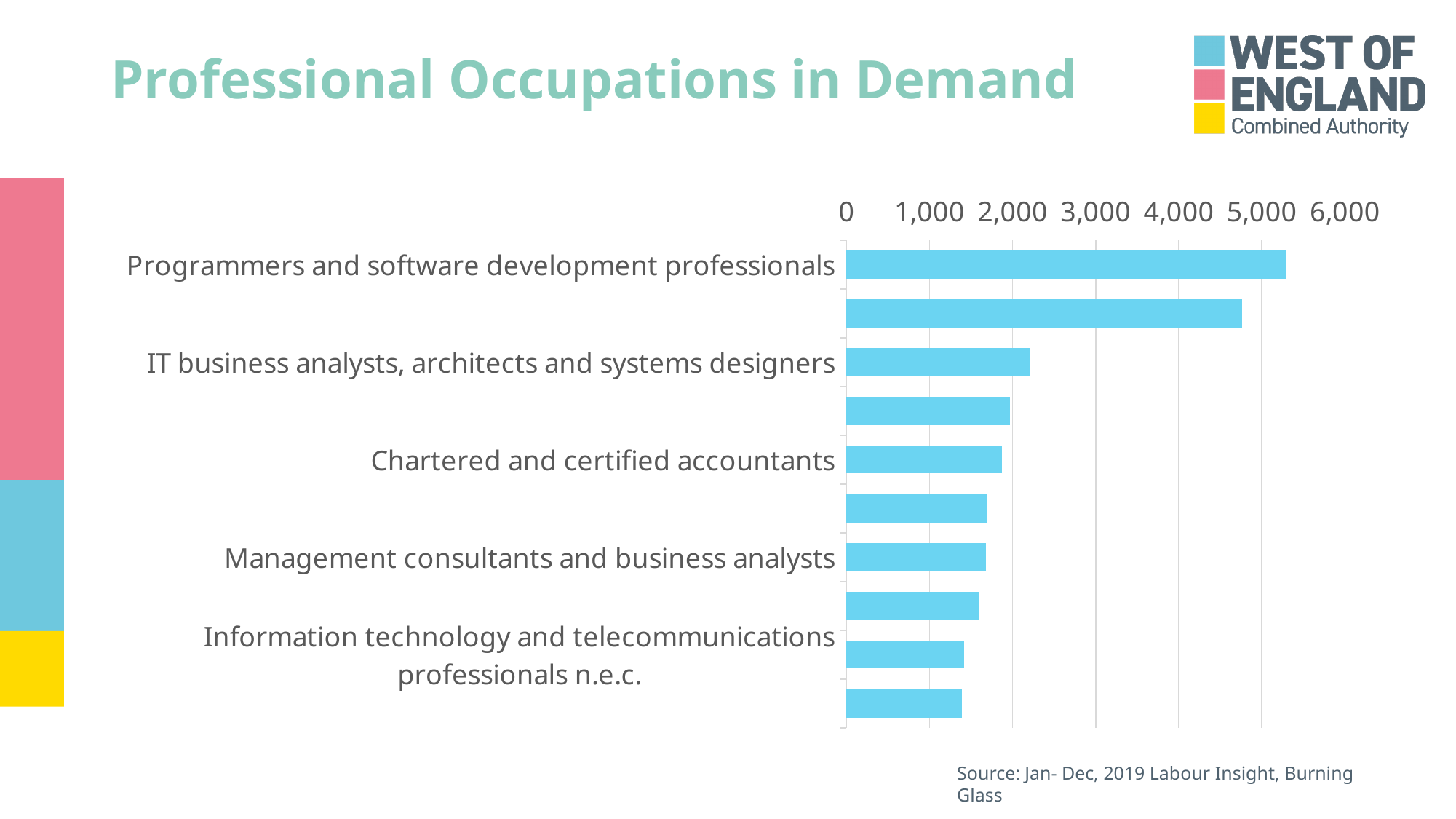
Is the value for Management consultants and business analysts greater or less than 2,000? less Is the value for Chartered and certified accountants greater or less than 1,000? greater Is the value for IT business analysts, architects and systems designers greater or less than 3,000? less Which occupation has the longest bar in the chart? Programmers and software development professionals How many bars are plotted in the chart? 10 Which is larger: the value for Programmers and software development professionals or the value for IT business analysts, architects and systems designers? Programmers and software development professionals What kind of chart is shown on the slide? bar chart What is the highest value shown on the chart's horizontal axis? 6,000 What is the title of the slide? Professional Occupations in Demand Which is larger: the value for Chartered and certified accountants or the value for Information technology and telecommunications professionals n.e.c.? Chartered and certified accountants